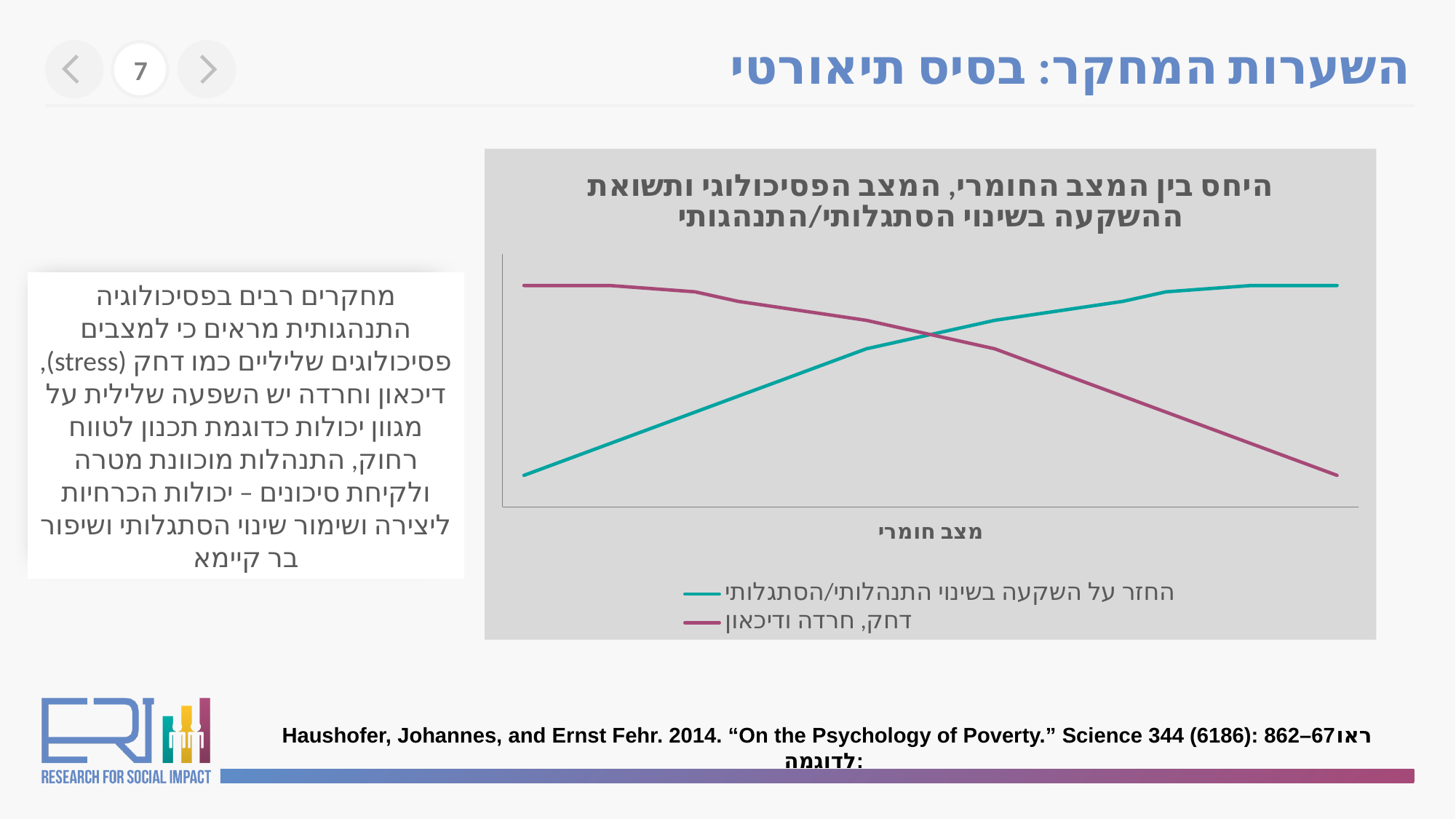
What is the label on the chart's x axis? מצב חומרי Which series is higher at the far left end of the chart: 'החזר על השקעה בשינוי התנהלותי/הסתגלותי' or 'דחק, חרדה ודיכאון'? דחק, חרדה ודיכאון From left to right along the x axis, does the line for 'החזר על השקעה בשינוי התנהלותי/הסתגלותי' rise or fall? Rise What colour is the line for 'דחק, חרדה ודיכאון' in the chart? Purple Which series is higher at the far right end of the chart: 'החזר על השקעה בשינוי התנהלותי/הסתגלותי' or 'דחק, חרדה ודיכאון'? החזר על השקעה בשינוי התנהלותי/הסתגלותי What kind of chart is shown on the slide? Line chart How many series does the chart's legend list? 2 From left to right along the x axis, does the line for 'דחק, חרדה ודיכאון' rise or fall? Fall